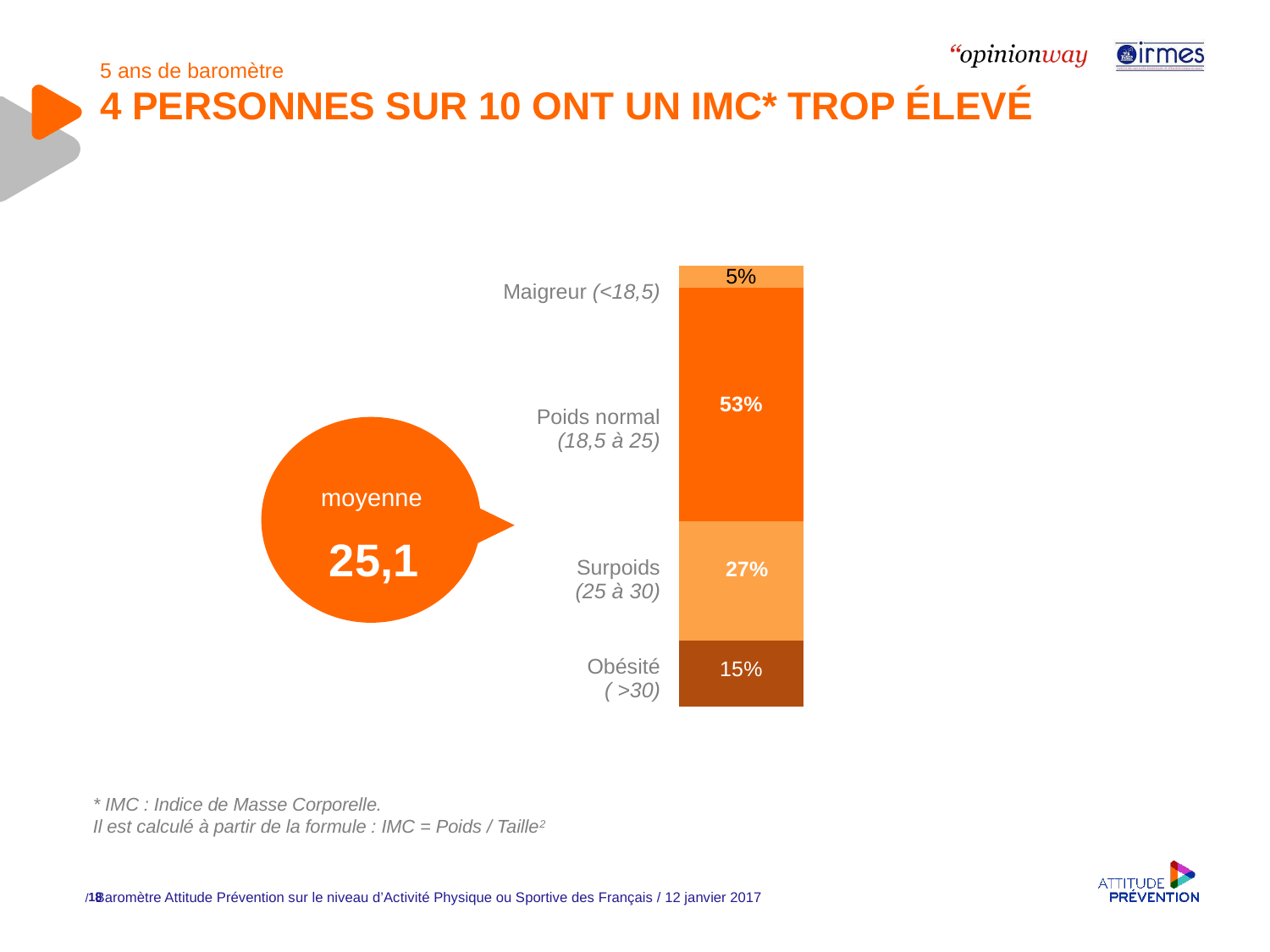
What percentage of people are in the "Surpoids (25 à 30)" category? 27% What type of chart is used to show the IMC categories? Stacked bar chart What percentage of people fall in the "Poids normal (18,5 à 25)" category? 53% Which IMC category has the smallest share? Maigreur (<18,5) Which IMC category has the largest share? Poids normal (18,5 à 25) Which segment is larger, "Surpoids" or "Obésité"? Surpoids What percentage of people are in the "Maigreur (<18,5)" category? 5% What percentage of people are in the "Obésité (>30)" category? 15% What is the difference in percentage points between the "Surpoids" and "Obésité" segments? 12 What average IMC value is shown in the orange circle next to the chart? 25,1 What is the combined percentage of the "Surpoids" and "Obésité" segments? 42% How many IMC categories are shown in the stacked bar? 4